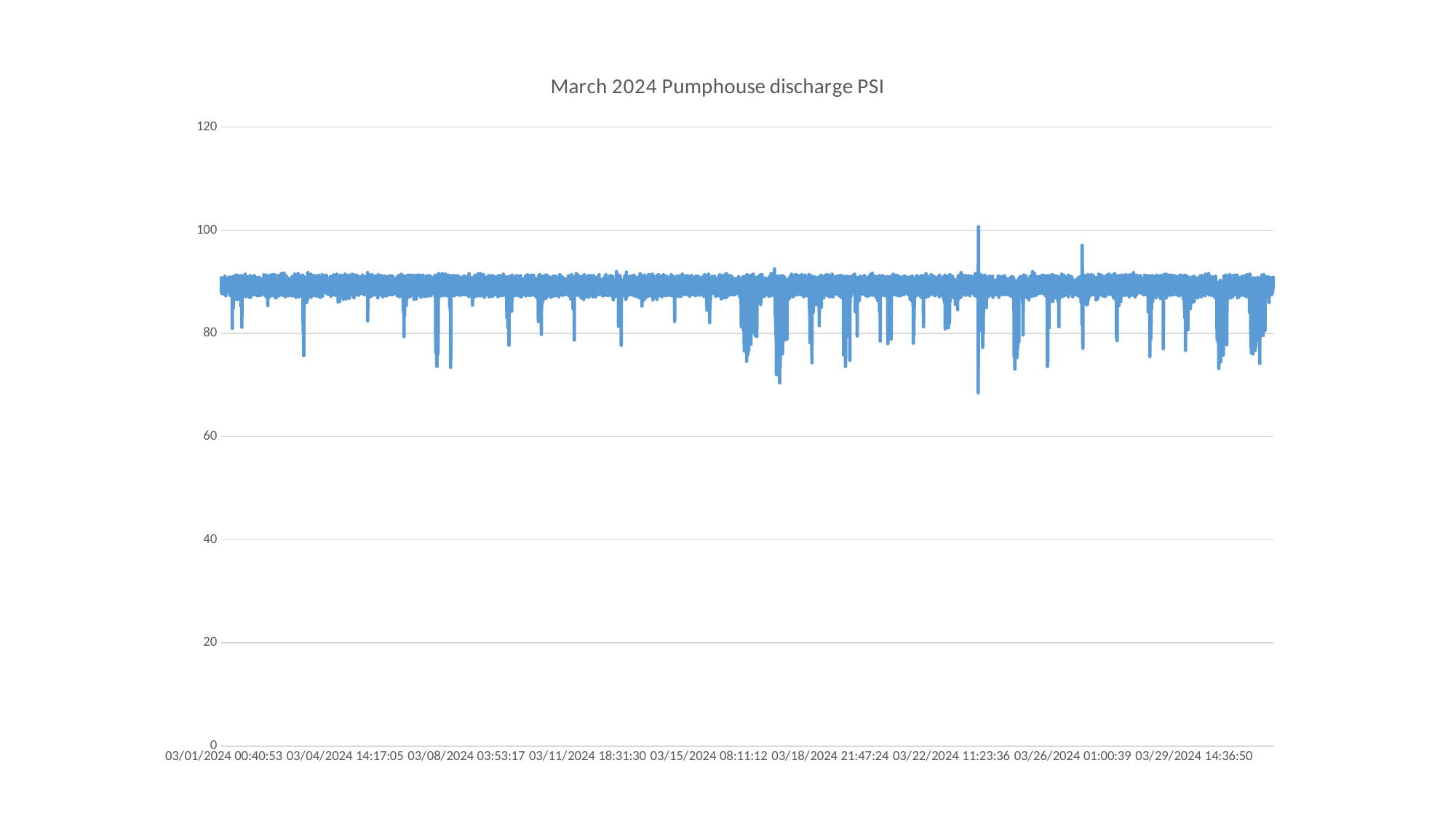
What is the title of the chart? March 2024 Pumphouse discharge PSI What is the first date label on the x axis? 03/01/2024 00:40:53 Does the series show a clear rising or falling trend across March 2024, or does it stay roughly flat? Roughly flat How many date labels are shown along the x axis? 9 Is the lowest dip in the series greater or less than 80? less How many data series are plotted on the chart? 1 What is the highest value shown on the vertical axis? 120 What kind of chart is shown on the slide? Line chart Is the typical (baseline) value of the series greater or less than 100? less Is the typical (baseline) value of the series greater or less than 80? greater